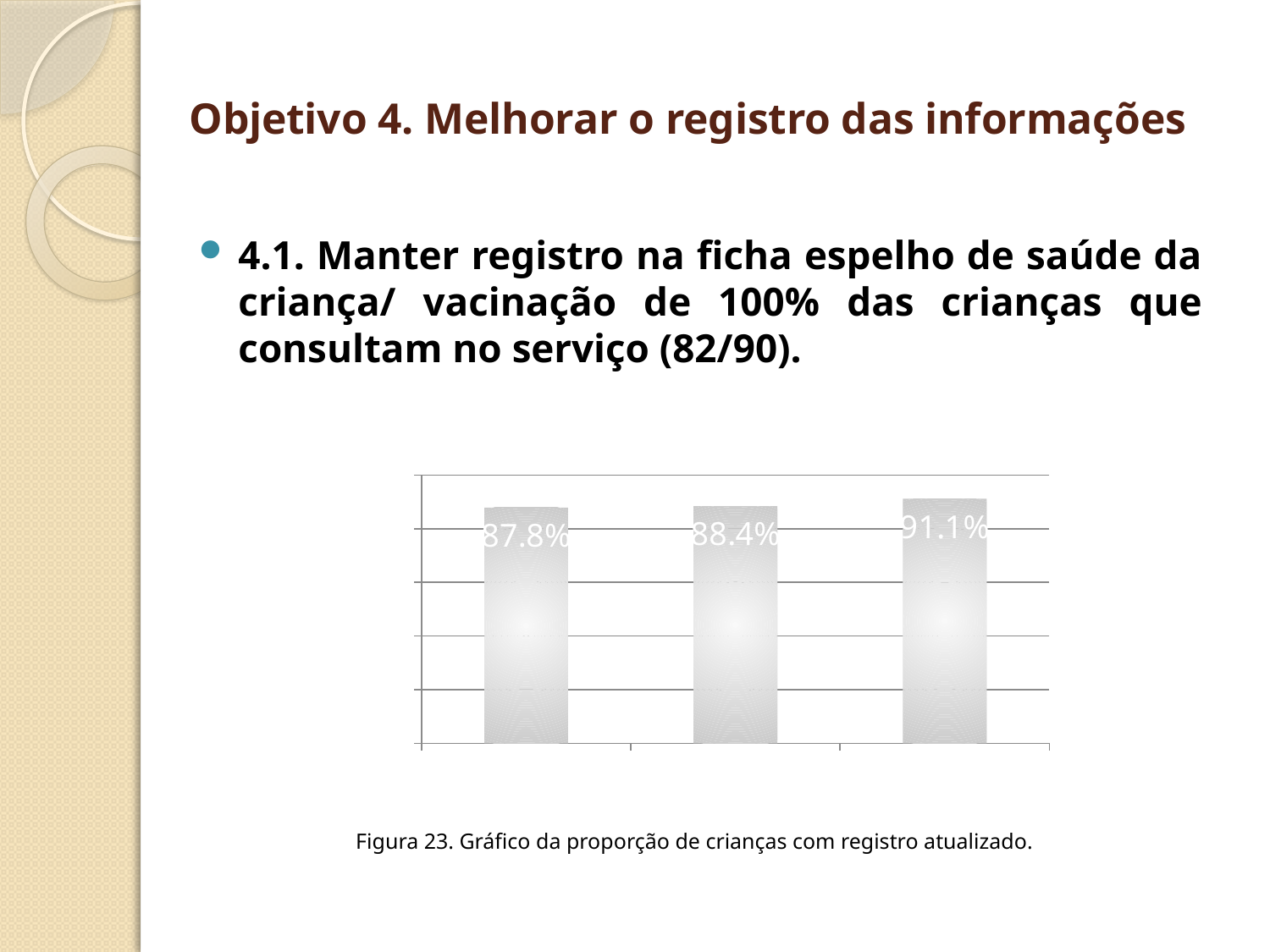
What value is shown on the first (leftmost) bar of the chart? 87.8% What value is shown on the middle bar of the chart? 88.4% How many bars are plotted in the chart? 3 What is the difference between the middle bar and the leftmost bar? 0.6 percentage points Do the values rise or fall from left to right across the chart? Rise What value is shown on the third (rightmost) bar of the chart? 91.1% Which bar has the lowest value in the chart? The first (leftmost) bar, 87.8% What is the figure caption shown below the chart? Figura 23. Gráfico da proporção de crianças com registro atualizado. Which is larger, the value of the middle bar or the value of the rightmost bar? The rightmost bar (91.1%) Which bar has the highest value in the chart? The third (rightmost) bar, 91.1% What is the difference between the rightmost bar and the leftmost bar? 3.3 percentage points What kind of chart is shown on the slide? Bar chart